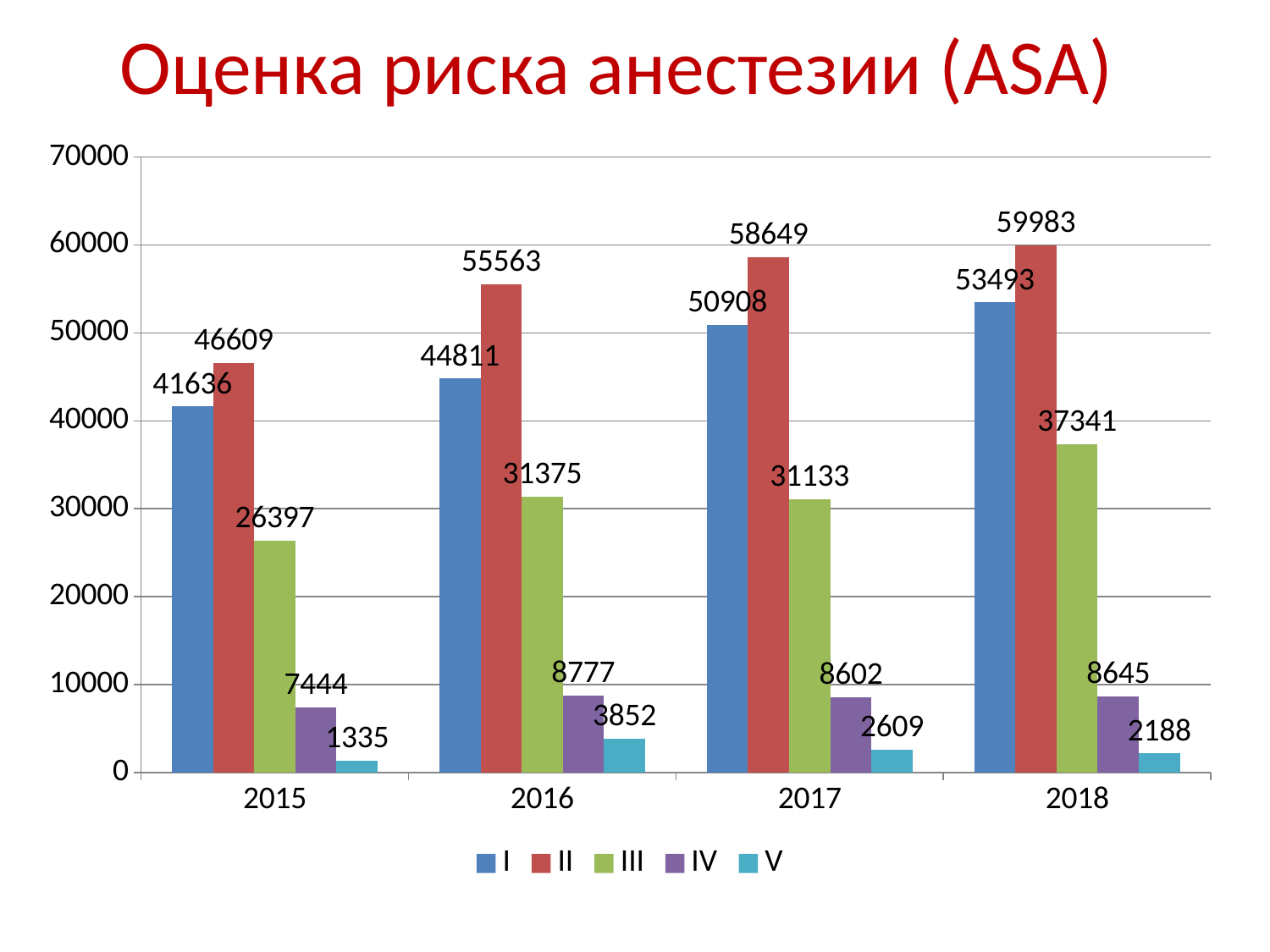
What is the value for series III in 2018? 37341 What is the title of the chart? Оценка риска анестезии (ASA) How many years are shown on the x axis? 4 In which year is the value for series V lowest? 2015 What is the value for series II in 2017? 58649 What is the value for series V in 2015? 1335 What is the difference between series II and series I in 2016? 10752 What kind of chart is shown on the slide? bar chart Which is larger in 2017: series III or series IV? III Do the values for series I rise or fall from 2015 to 2018? rise In which year is the value for series II highest? 2018 How many series does the legend list? 5